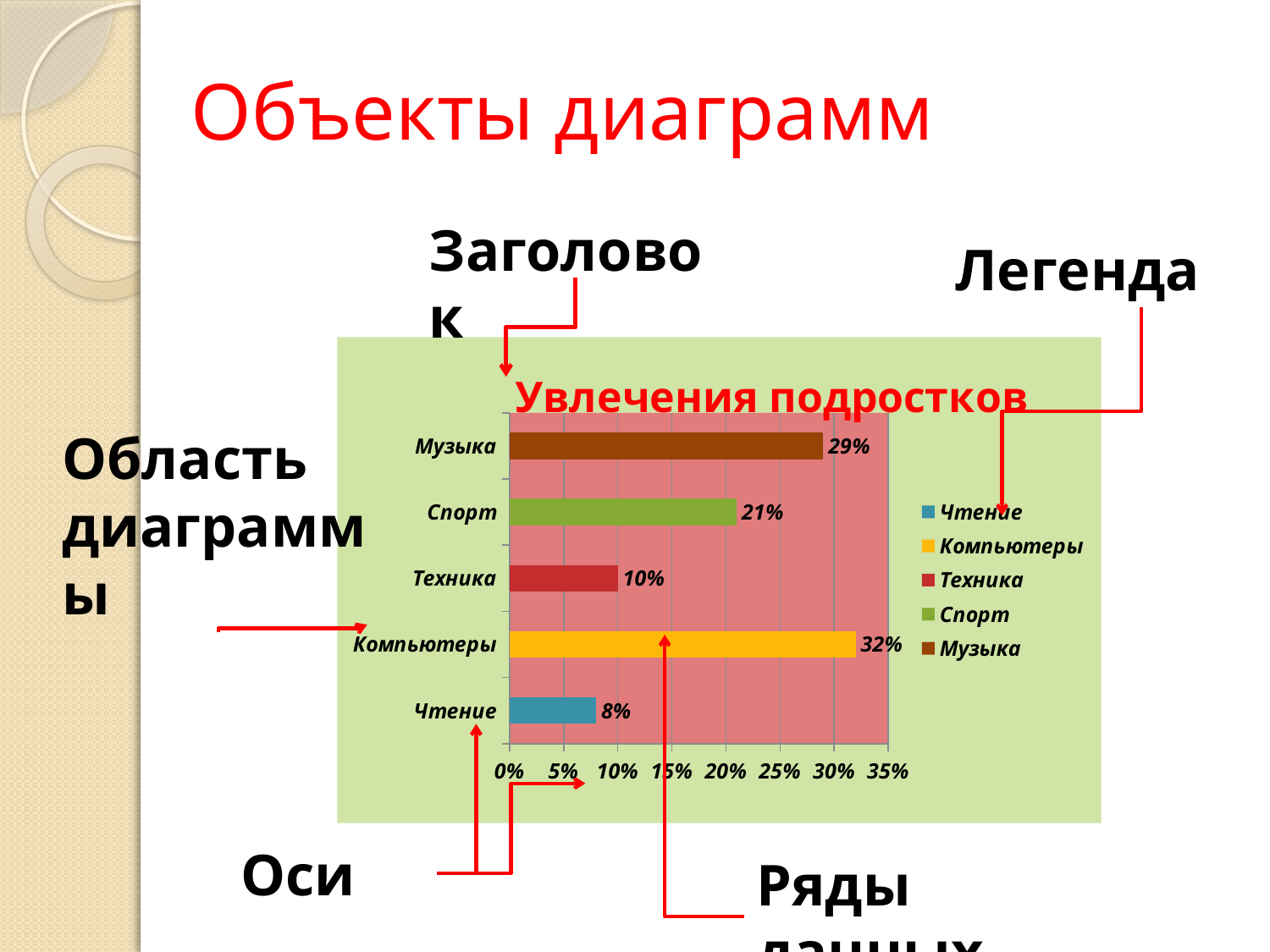
What is the value for Спорт? 21% How many entries does the legend list? 5 What is the value for Чтение? 8% What kind of chart is shown on the slide? bar chart Which category has the lowest value? Чтение What is the difference between the values for Музыка and Техника? 19% How many categories are shown in the chart? 5 What is the value for Компьютеры? 32% What is the title of the chart? Увлечения подростков Which is larger, the value for Музыка or the value for Спорт? Музыка Is the value for Техника greater or less than 15%? less Which category has the highest value? Компьютеры